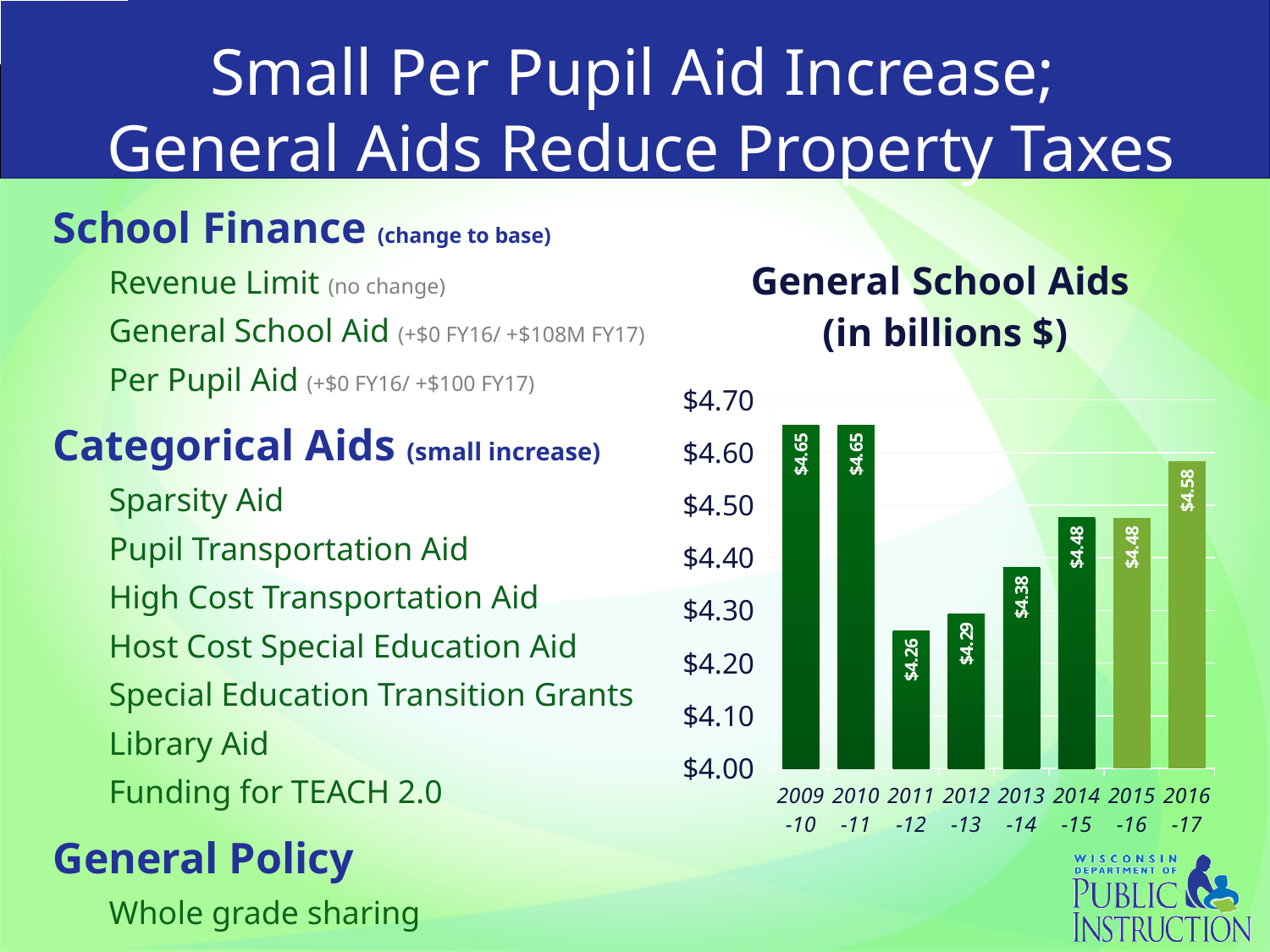
What is the value for 2011-12 in the General School Aids chart? $4.26 Is the value for 2013-14 in the General School Aids chart greater or less than $4.40? less What is the difference between the 2009-10 and 2015-16 values in the General School Aids chart? $0.17 Do the values in the General School Aids chart rise or fall from 2011-12 to 2016-17? rise Which year has the lowest value in the General School Aids chart? 2011-12 What is the difference between the 2016-17 and 2011-12 values in the General School Aids chart? $0.32 How many years are shown in the General School Aids chart? 8 What kind of chart is the General School Aids chart? bar chart What is the value for 2016-17 in the General School Aids chart? $4.58 What unit does the title of the General School Aids chart say the values are in? billions $ What is the value for 2013-14 in the General School Aids chart? $4.38 Which is larger in the General School Aids chart, the value for 2012-13 or the value for 2014-15? 2014-15